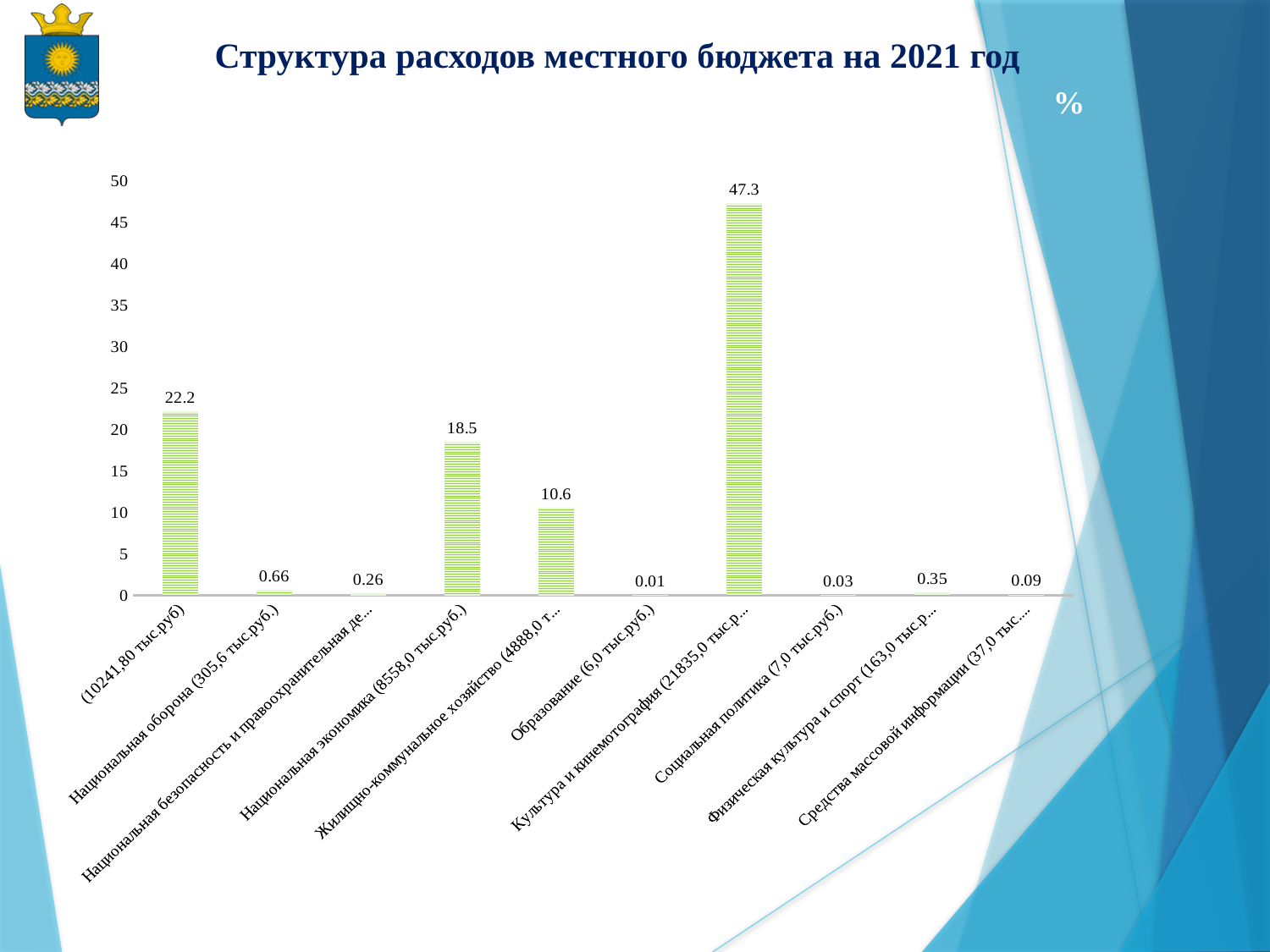
How many categories are shown in the chart? 10 Is the value for Культура и кинемотография greater or less than 45? greater What kind of chart is shown on the slide? bar chart Which is larger, the value for Национальная экономика or the value for Жилищно-коммунальное хозяйство? Национальная экономика What is the value for Образование? 0.01 What is the value for Жилищно-коммунальное хозяйство? 10.6 What is the value for Национальная экономика? 18.5 Which category has the lowest value? Образование What is the value for Культура и кинемотография? 47.3 What is the value for Национальная оборона? 0.66 Which category has the highest value? Культура и кинемотография What is the difference between the values for Культура и кинемотография and Национальная экономика? 28.8